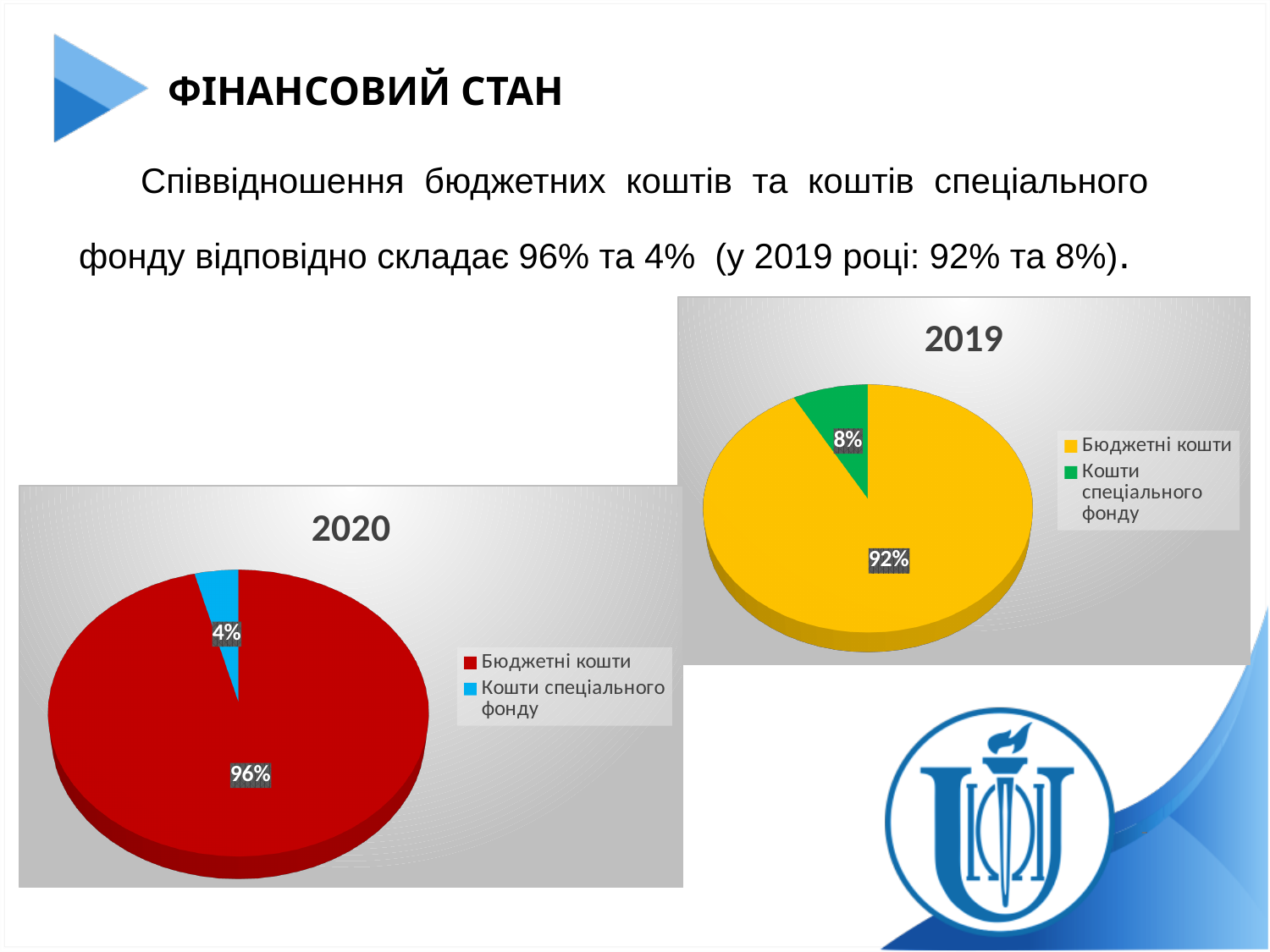
In the 2020 pie chart, what share is labelled for Бюджетні кошти? 96% In the 2019 pie chart, what share is labelled for Кошти спеціального фонду? 8% In the 2019 pie chart, what share is labelled for Бюджетні кошти? 92% In the 2020 pie chart, what is the difference in percentage points between Бюджетні кошти and Кошти спеціального фонду? 92 In the 2020 pie chart, which category has the largest slice? Бюджетні кошти What type of chart is the 2020 chart? Pie chart In the 2019 pie chart, which category has the smallest slice? Кошти спеціального фонду Is the share of Кошти спеціального фонду larger in the 2019 pie chart or the 2020 pie chart? 2019 In the 2020 pie chart, what share is labelled for Кошти спеціального фонду? 4% How many entries does the legend of the 2020 pie chart list? 2 In the 2019 pie chart, what colour is the slice for Бюджетні кошти? Yellow How many slices does the 2019 pie chart have? 2